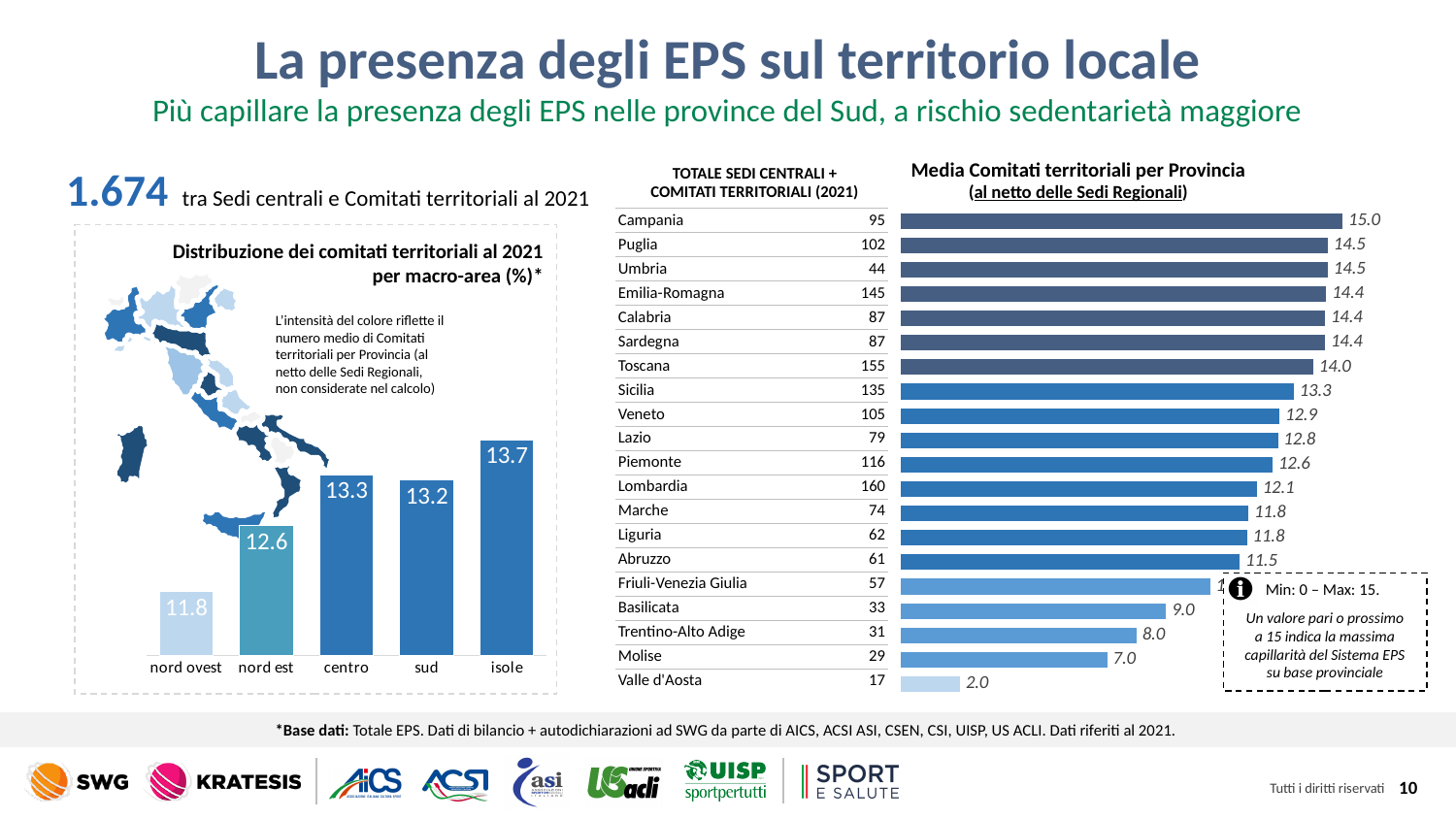
In the chart 'Media Comitati territoriali per Provincia', which is larger, the value for Lombardia or the value for Abruzzo? Lombardia In the chart 'Media Comitati territoriali per Provincia', which region has the lowest value? Valle d'Aosta What kind of chart is 'Distribuzione dei comitati territoriali al 2021 per macro-area (%)'? bar chart In the chart 'Distribuzione dei comitati territoriali al 2021 per macro-area (%)', what is the difference between isole and nord ovest? 1.9 In the chart 'Media Comitati territoriali per Provincia', what is the value for Toscana? 14.0 In the chart 'Distribuzione dei comitati territoriali al 2021 per macro-area (%)', which macro-area has the lowest value? nord ovest In the chart 'Media Comitati territoriali per Provincia', which region has the highest value? Campania In the chart 'Distribuzione dei comitati territoriali al 2021 per macro-area (%)', what is the value for isole? 13.7 In the chart 'Media Comitati territoriali per Provincia', what is the value for Trentino-Alto Adige? 8.0 In the chart 'Distribuzione dei comitati territoriali al 2021 per macro-area (%)', how many macro-areas are shown? 5 In the table 'TOTALE SEDI CENTRALI + COMITATI TERRITORIALI (2021)', what is the value for Lombardia? 160 In the chart 'Media Comitati territoriali per Provincia', what is the difference between Basilicata and Molise? 2.0